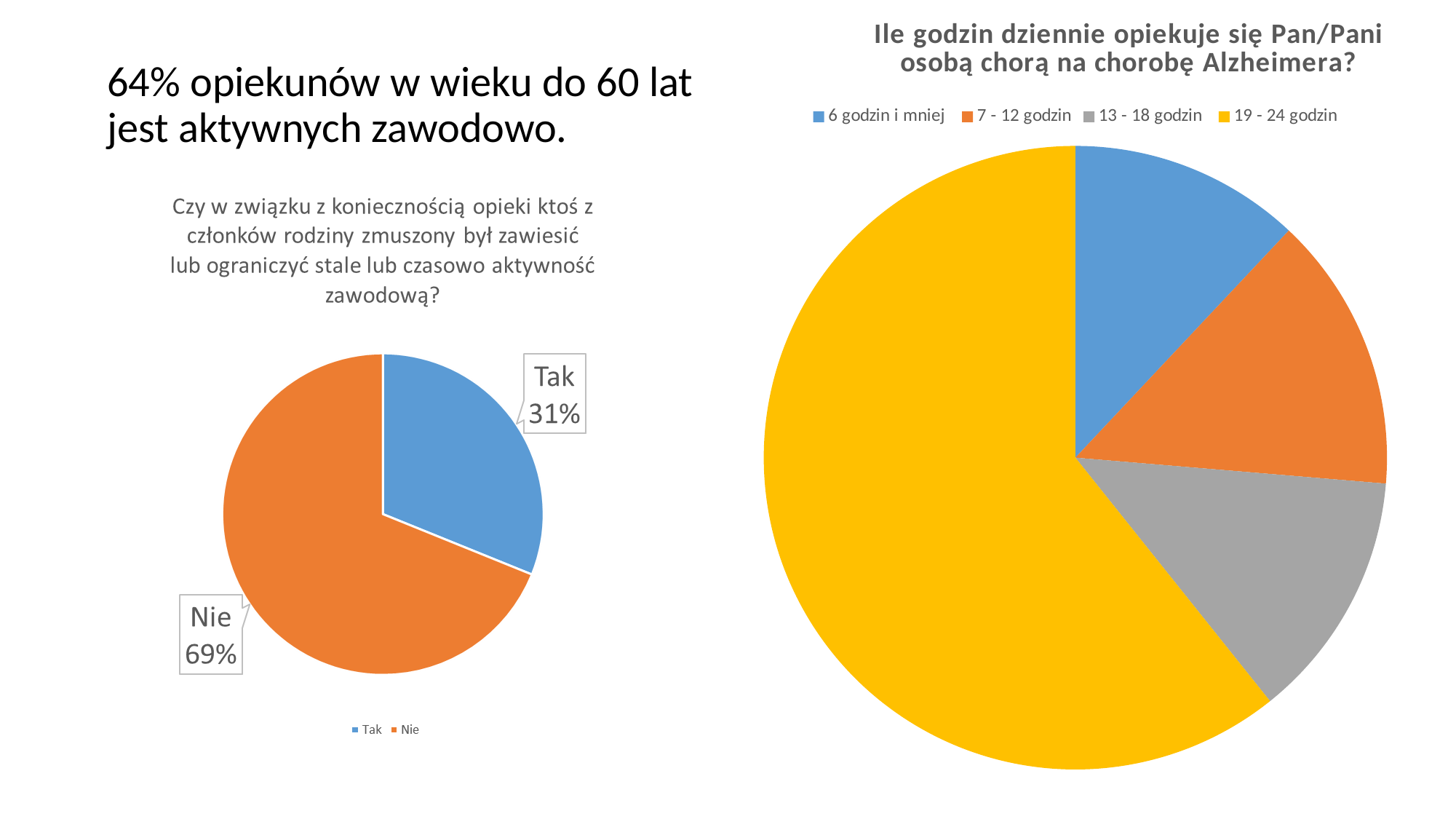
How many slices does the left chart have? 2 In the chart titled "Ile godzin dziennie opiekuje się Pan/Pani osobą chorą na chorobę Alzheimera?", which is larger, the slice for "19 - 24 godzin" or the slice for "13 - 18 godzin"? 19 - 24 godzin In the chart titled "Ile godzin dziennie opiekuje się Pan/Pani osobą chorą na chorobę Alzheimera?", how many categories does the legend list? 4 What kind of chart is the left chart? Pie chart In the left chart, what percentage answered "Tak"? 31% In the left chart, which slice is the largest? Nie In the left chart, what is the difference in percentage points between "Nie" and "Tak"? 38 In the chart titled "Ile godzin dziennie opiekuje się Pan/Pani osobą chorą na chorobę Alzheimera?", what colour is the slice for "13 - 18 godzin"? Grey In the left chart, what percentage answered "Nie"? 69% In the left chart, which answer has the larger share, "Tak" or "Nie"? Nie In the left chart, which slice is the smallest? Tak In the chart titled "Ile godzin dziennie opiekuje się Pan/Pani osobą chorą na chorobę Alzheimera?", which category has the largest slice? 19 - 24 godzin